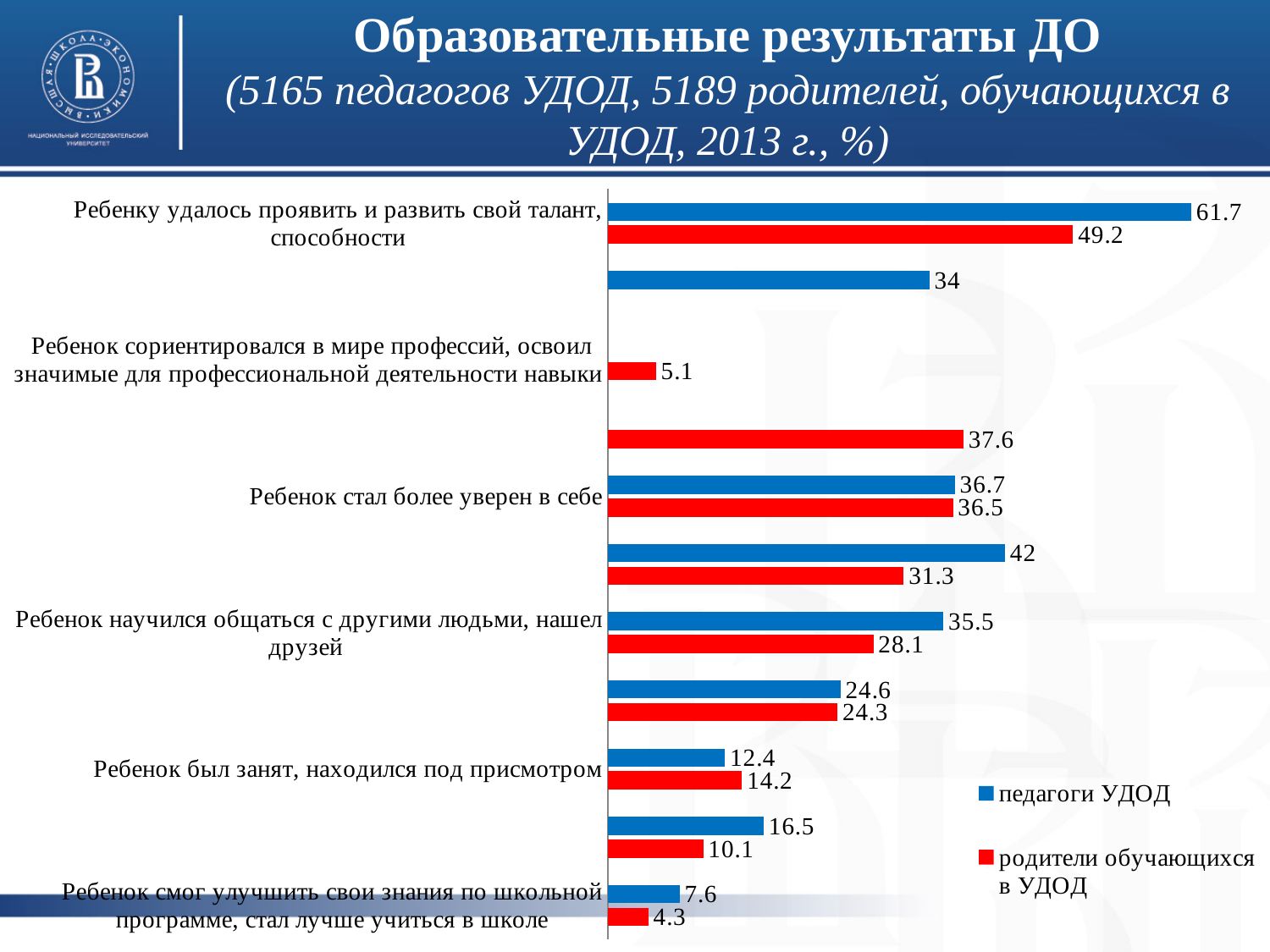
What is the difference between the педагоги УДОД and родители values for 'Ребенку удалось проявить и развить свой талант, способности'? 12.5 How many series does the legend list? 2 What is the difference between the педагоги УДОД and родители values for 'Ребенок научился общаться с другими людьми, нашел друзей'? 7.4 What is the value for педагоги УДОД for 'Ребенку удалось проявить и развить свой талант, способности'? 61.7 What is the value for родители обучающихся в УДОД for 'Ребенку удалось проявить и развить свой талант, способности'? 49.2 What kind of chart is shown on the slide? bar chart What is the value for педагоги УДОД for 'Ребенок стал более уверен в себе'? 36.7 What are the two series named in the legend? педагоги УДОД; родители обучающихся в УДОД What is the value for родители обучающихся в УДОД for 'Ребенок смог улучшить свои знания по школьной программе, стал лучше учиться в школе'? 4.3 For 'Ребенок был занят, находился под присмотром', which series has the larger value: педагоги УДОД or родители обучающихся в УДОД? родители обучающихся в УДОД What is the value for родители обучающихся в УДОД for 'Ребенок научился общаться с другими людьми, нашел друзей'? 28.1 Which category has the highest value for педагоги УДОД? Ребенку удалось проявить и развить свой талант, способности